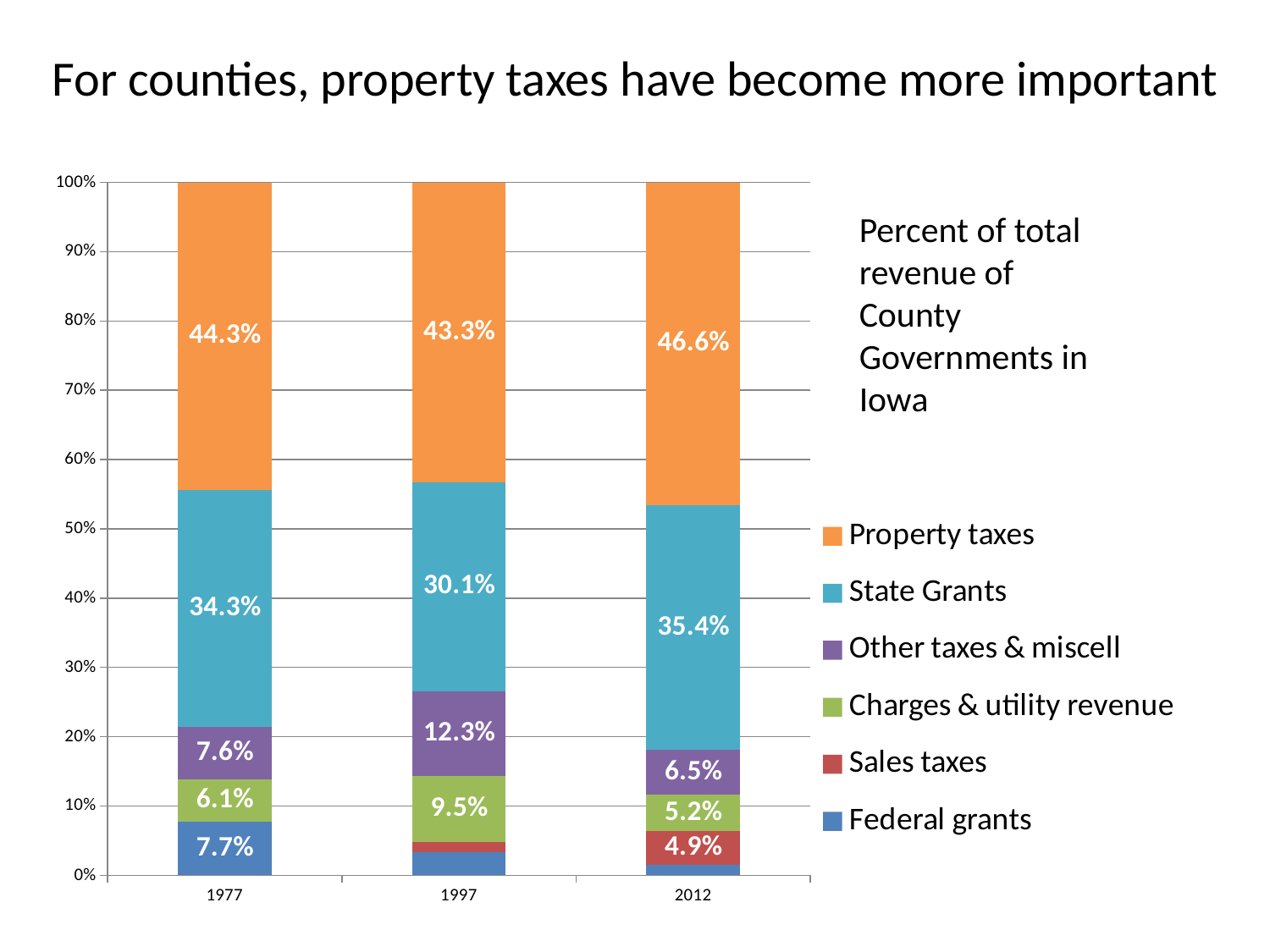
What share of county revenue came from State Grants in 1997? 30.1% How many series does the legend list? 6 In which year was the Property taxes share the highest? 2012 Is the Federal grants share in 2012 greater or less than 10%? less Which was larger in 1997, Charges & utility revenue or Other taxes & miscell? Other taxes & miscell What share of county revenue came from Property taxes in 2012? 46.6% What was the Federal grants share in 1977? 7.7% What was the Sales taxes share in 2012? 4.9% By how many percentage points did the Property taxes share change from 1997 to 2012? 3.3 percentage points In which year was the Other taxes & miscell share the lowest? 2012 What kind of chart is shown on the slide? Stacked bar chart How many years are shown on the x axis? 3